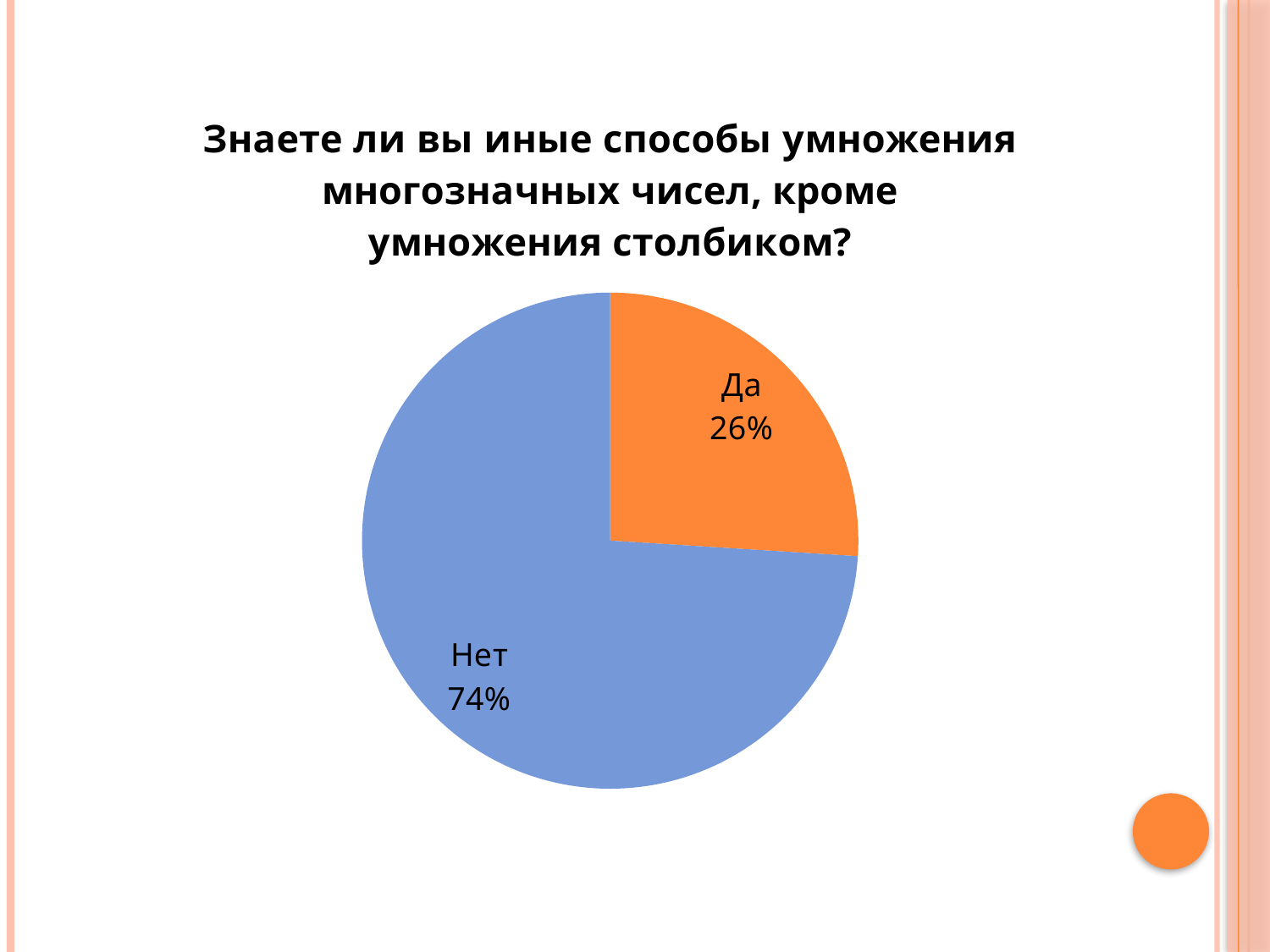
Which slice of the pie is the smallest? Да What kind of chart is shown on the slide? pie chart Which slice of the pie is the largest? Нет What is the title of the chart? Знаете ли вы иные способы умножения многозначных чисел, кроме умножения столбиком? What is the total of the two slice percentages shown? 100% What share of the pie does the "Нет" slice represent? 74% What share of the pie does the "Да" slice represent? 26% Which is larger, the "Да" slice or the "Нет" slice? Нет What colour is the "Да" slice? orange How many slices does the pie chart have? 2 What is the difference in percentage points between the "Нет" and "Да" slices? 48